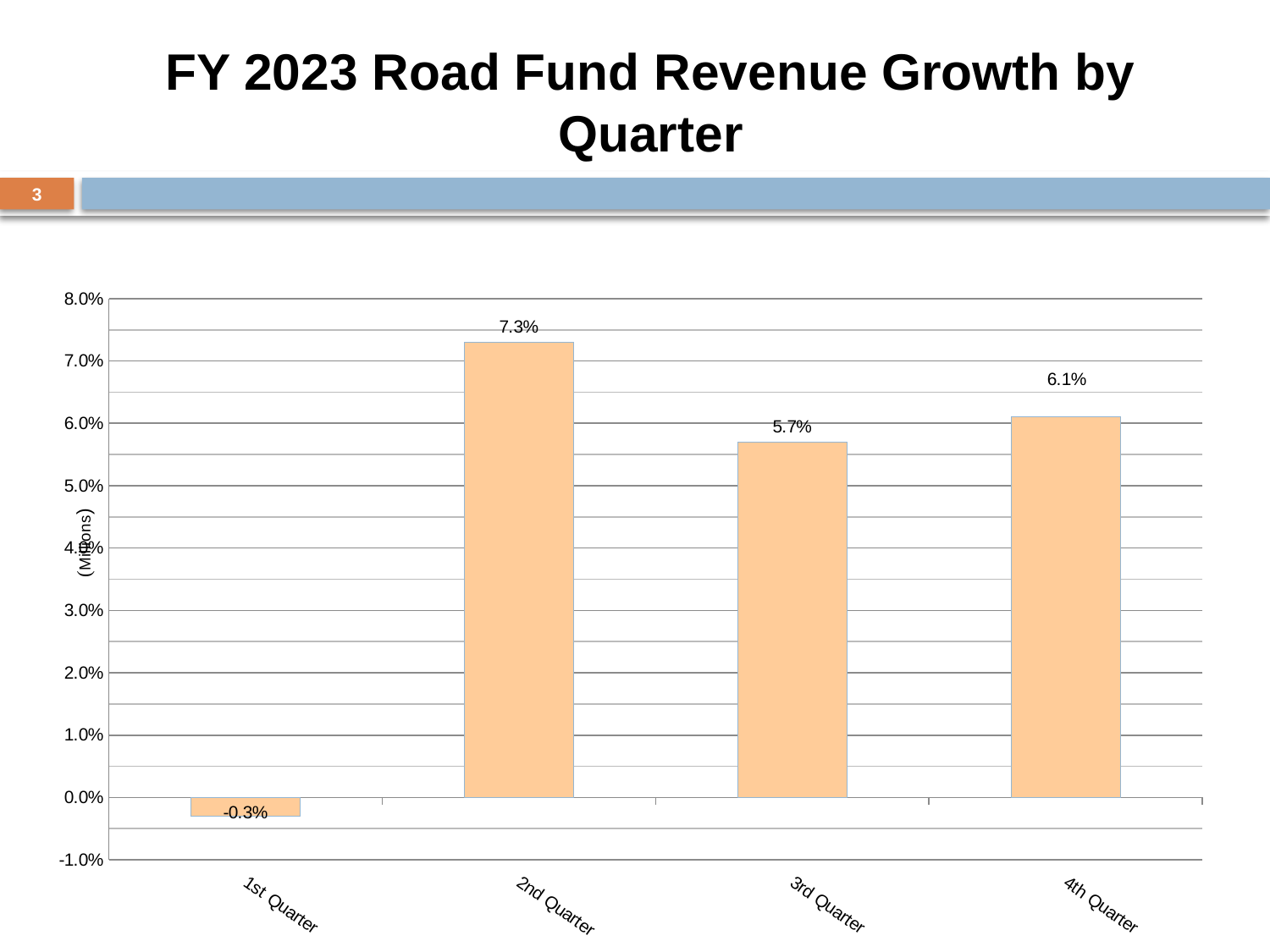
What kind of chart is shown on the slide? bar chart Is the value for the 3rd Quarter greater or less than 5.0%? greater What is the title of the slide? FY 2023 Road Fund Revenue Growth by Quarter What is the difference between the 2nd Quarter and 3rd Quarter values? 1.6% What is the revenue growth value for the 1st Quarter? -0.3% Which quarter has the lowest revenue growth? 1st Quarter What is the revenue growth value for the 4th Quarter? 6.1% Does the value rise or fall from the 1st Quarter to the 2nd Quarter? rise What is the revenue growth value for the 2nd Quarter? 7.3% Which is larger, the value for the 3rd Quarter or the 4th Quarter? 4th Quarter Which quarter has the highest revenue growth? 2nd Quarter How many quarters are shown on the chart? 4